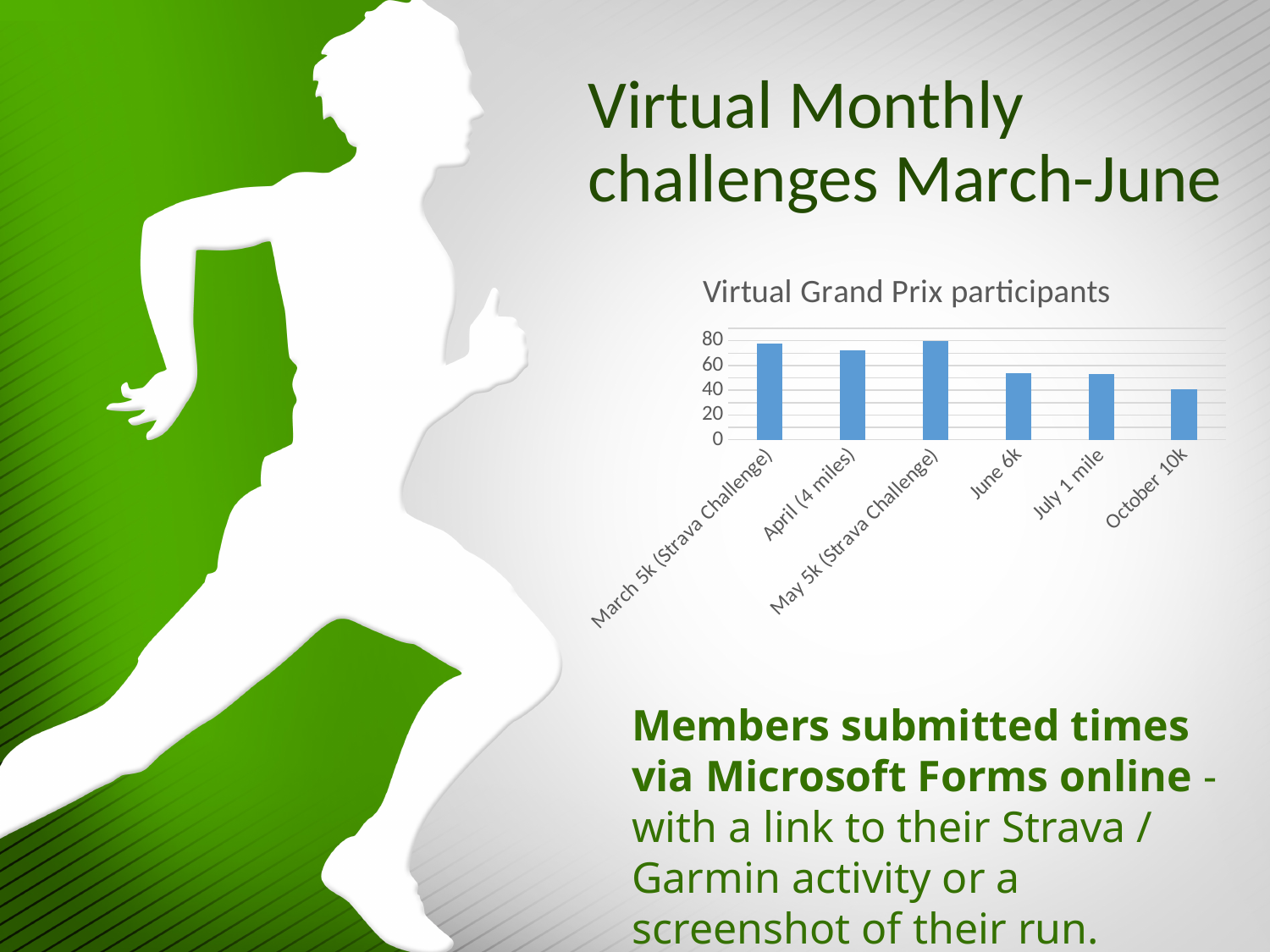
Which has more participants, March 5k (Strava Challenge) or June 6k? March 5k (Strava Challenge) What is the title of the chart on the slide? Virtual Grand Prix participants What kind of chart is shown on the slide? bar chart Is the value for March 5k (Strava Challenge) greater or less than 60? greater Is the value for June 6k greater or less than 40? greater Is the value for April (4 miles) greater or less than 60? greater Do participant numbers generally rise or fall from the first event to the last event along the x axis? fall How many categories (events) are shown in the chart? 6 Which event has the lowest number of participants? October 10k